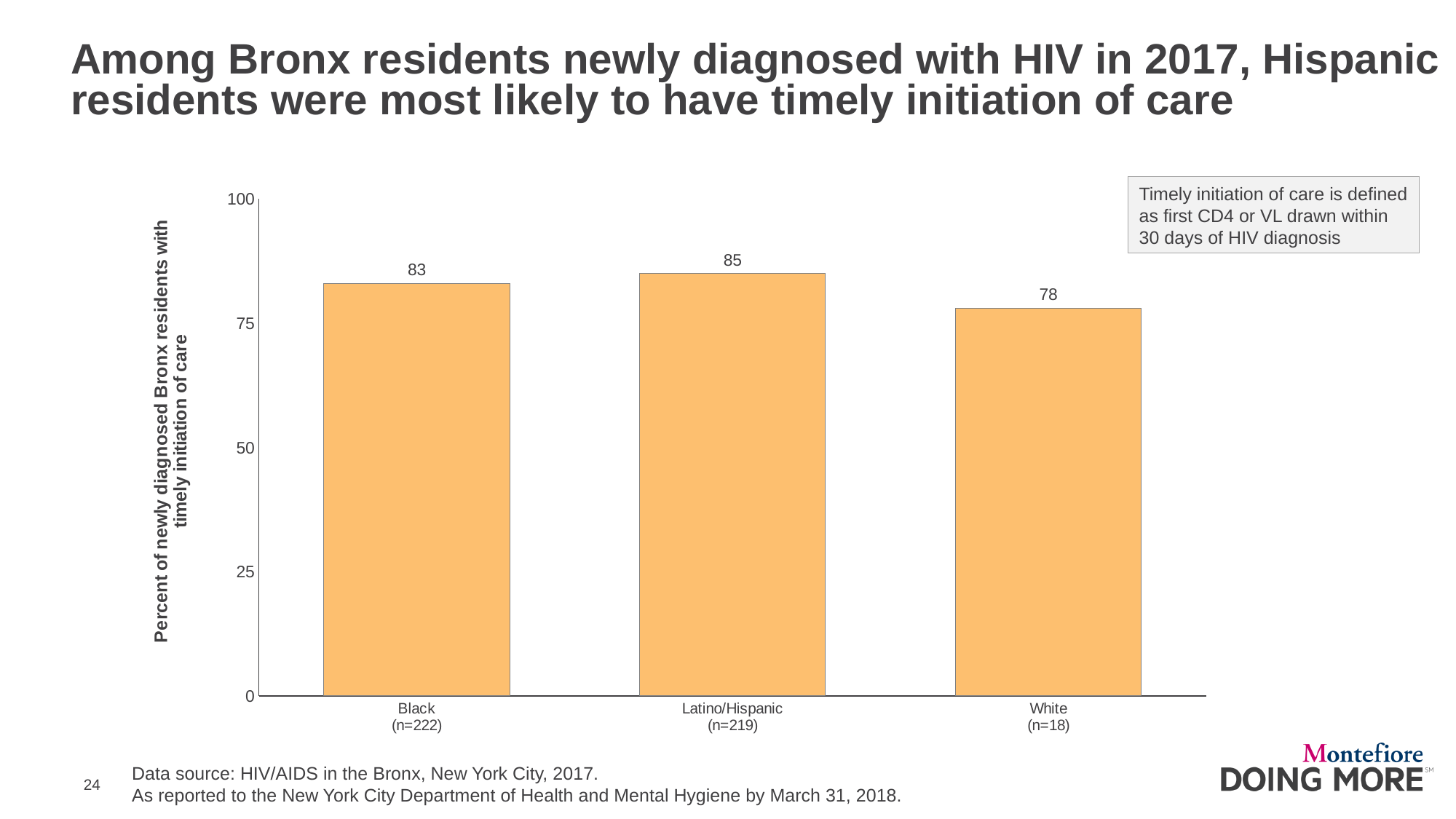
What is the difference between the Black and White values? 5 What type of chart is shown on the slide? bar chart Which racial/ethnic group has the highest percent with timely initiation of care? Latino/Hispanic Which is larger, the value for Black residents or the value for White residents? Black How many racial/ethnic groups are shown in the chart? 3 What is the value shown for White residents? 78 What is the difference between the Latino/Hispanic and White values? 7 Is the value for White residents greater or less than 75? greater What is the sample size (n) shown for the White group? n=18 What percent of newly diagnosed Black Bronx residents had timely initiation of care? 83 Which racial/ethnic group has the lowest percent with timely initiation of care? White What is the value shown for Latino/Hispanic residents? 85